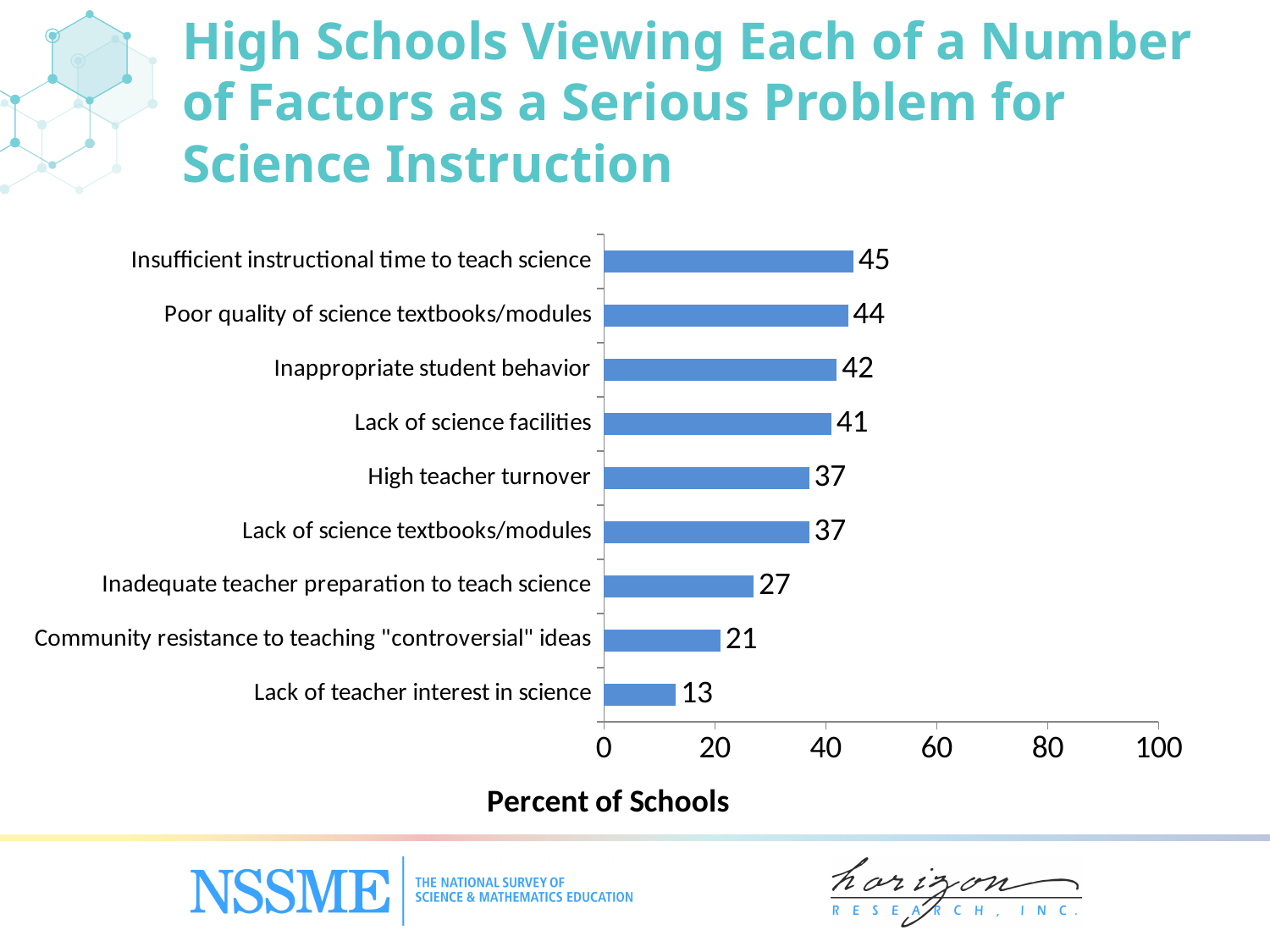
What is the value for inadequate teacher preparation to teach science? 27 Is the value for inappropriate student behavior greater or less than 40? greater What kind of chart is shown on the slide? Bar chart Which factor has the highest percent of schools viewing it as a serious problem? Insufficient instructional time to teach science What is the label of the horizontal axis? Percent of Schools Which is larger: the value for lack of science facilities or the value for high teacher turnover? Lack of science facilities What is the difference between the values for poor quality of science textbooks/modules and community resistance to teaching "controversial" ideas? 23 Which factor has the lowest percent of schools viewing it as a serious problem? Lack of teacher interest in science What is the maximum value shown on the horizontal axis? 100 What percent of schools view insufficient instructional time to teach science as a serious problem? 45 How many factors are shown in the chart? 9 What is the value for lack of teacher interest in science? 13